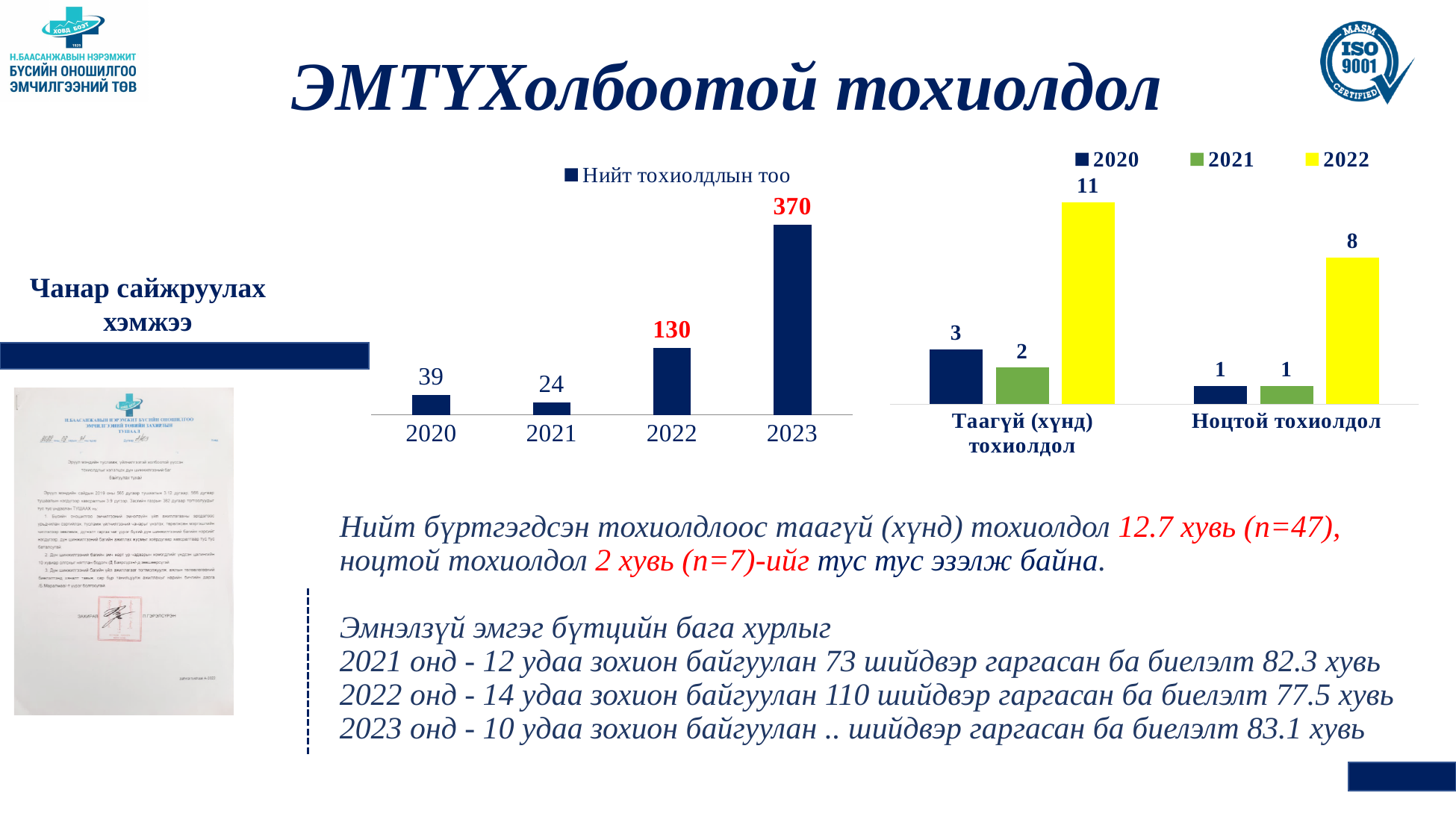
In the left chart titled 'Нийт тохиолдлын тоо', which year has the highest value? 2023 In the right chart, what is the 2022 value for 'Таагүй (хүнд) тохиолдол'? 11 In the right chart, what is the difference between the 2022 values for 'Таагүй (хүнд) тохиолдол' and 'Ноцтой тохиолдол'? 3 What kind of chart is the left chart titled 'Нийт тохиолдлын тоо'? Bar chart In the left chart titled 'Нийт тохиолдлын тоо', which year has the lowest value? 2021 In the left chart titled 'Нийт тохиолдлын тоо', what is the value for 2021? 24 In the left chart titled 'Нийт тохиолдлын тоо', how many years are shown on the x axis? 4 In the right chart, what is the 2020 value for 'Ноцтой тохиолдол'? 1 In the right chart, how many series does the legend list? 3 In the left chart titled 'Нийт тохиолдлын тоо', what is the difference between the values for 2023 and 2022? 240 In the left chart titled 'Нийт тохиолдлын тоо', what is the value for 2023? 370 In the right chart, which is larger for 'Таагүй (хүнд) тохиолдол': the 2020 value or the 2021 value? 2020